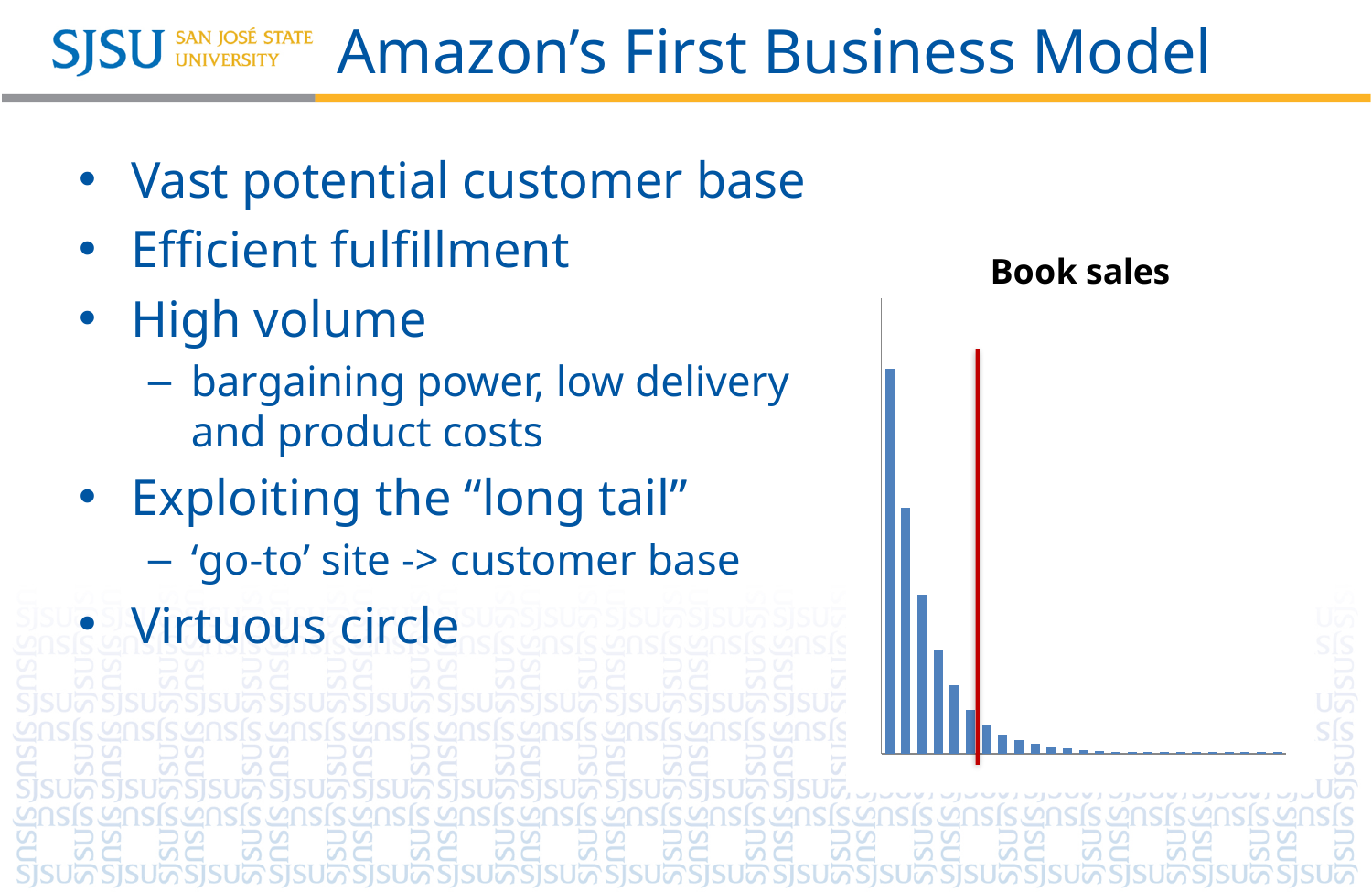
In the "Book sales" chart, is the first (leftmost) bar taller or shorter than the second bar? taller Does the "Book sales" chart show a legend? No Are the bars in the "Book sales" chart vertical or horizontal? vertical Do the bar heights in the "Book sales" chart rise or fall from left to right? fall What kind of chart is shown under the title "Book sales"? bar chart In the "Book sales" chart, which bar is the tallest: the leftmost bar or the rightmost bar? the leftmost bar In the "Book sales" chart, are the bars to the right of the red vertical line taller or shorter than the bars to its left? shorter What is the title of the chart on the slide? Book sales What colour are the bars in the "Book sales" chart? blue